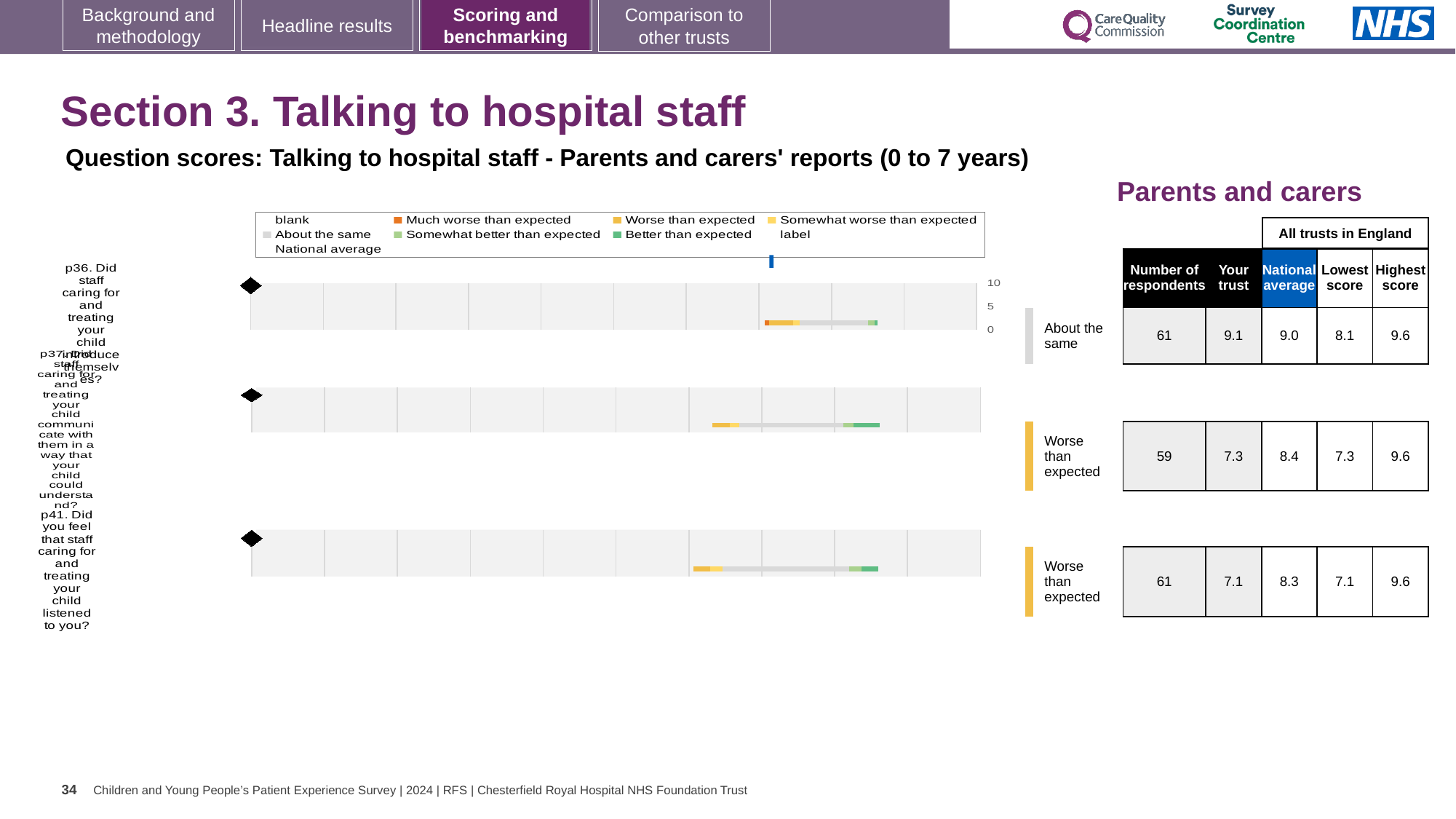
What is the highest tick value shown on the chart's axis? 10 What kind of chart is shown on the slide? bar chart According to the table beside the chart, how many respondents answered p37? 59 According to the table beside the chart, is the trust score for p36 higher or lower than the national average for p36? higher According to the table beside the chart, what is the national average for p41 (Did staff listen to you)? 8.3 According to the table beside the chart, what is the 'Your trust' score for p36 (Did staff introduce themselves)? 9.1 According to the table beside the chart, which of the three questions has the highest 'Your trust' score? p36 Which legend entry is shown in orange? Much worse than expected According to the table beside the chart, what is the difference between the national average and the trust score for p37? 1.1 How many entries does the chart's legend list? 9 How many question categories (bars) does the chart show? 3 According to the table beside the chart, which of the three questions has the lowest 'Your trust' score? p41